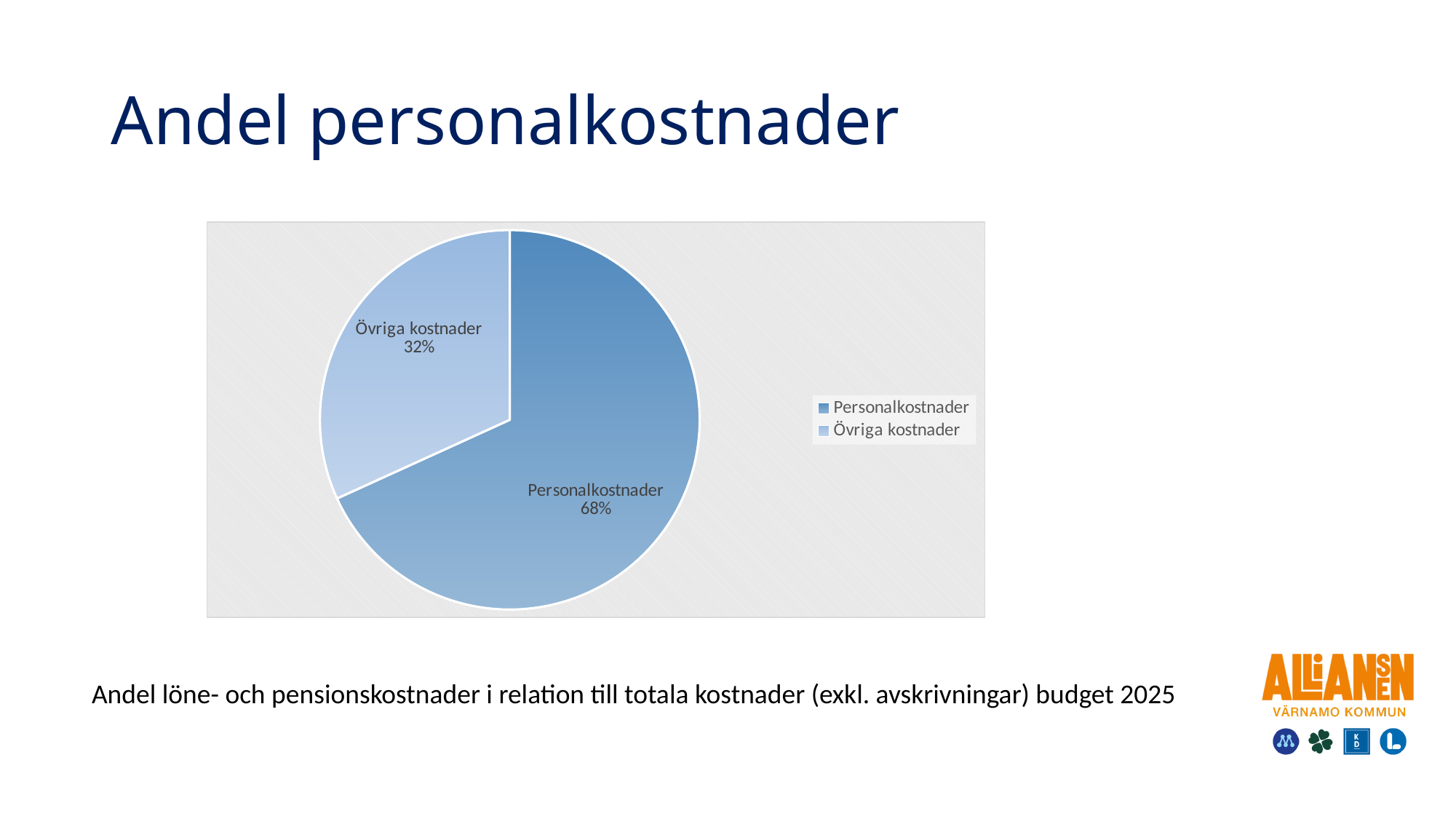
What kind of chart is shown on the slide? Pie chart How many entries does the legend list? 2 Which slice of the pie is the largest? Personalkostnader How many slices does the pie chart have? 2 Which slice is shown in the lighter blue colour? Övriga kostnader What share of the pie does Personalkostnader represent? 68% What share of the pie does Övriga kostnader represent? 32% What is the difference in percentage points between Personalkostnader and Övriga kostnader? 36 percentage points Which slice of the pie is the smallest? Övriga kostnader Is the share for Personalkostnader greater or less than 50%? greater Which is larger, Personalkostnader or Övriga kostnader? Personalkostnader What is the title of the slide containing the pie chart? Andel personalkostnader